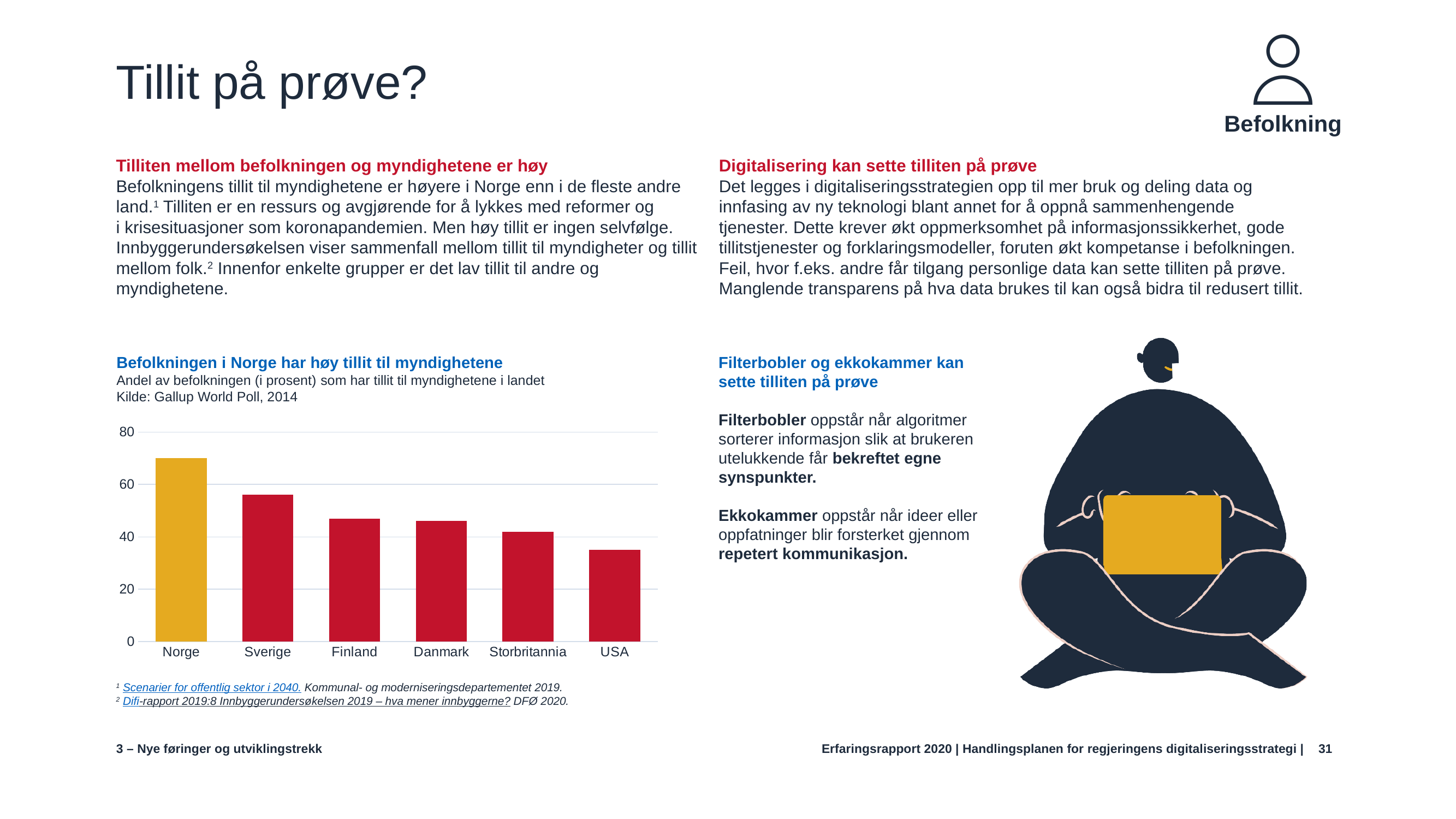
Is the value for Sverige greater or less than 60? less How many countries are shown in the chart? 6 Which is larger, the value for Norge or the value for Sverige? Norge Is the value for Finland greater or less than 40? greater What is the title of the chart? Befolkningen i Norge har høy tillit til myndighetene Which is larger, the value for Storbritannia or the value for USA? Storbritannia Is the value for USA greater or less than 40? less Which country has the lowest share of the population with trust in the authorities? USA What kind of chart is shown on the slide? bar chart Do the values rise or fall from left to right across the countries? fall Which country has the highest share of the population with trust in the authorities? Norge